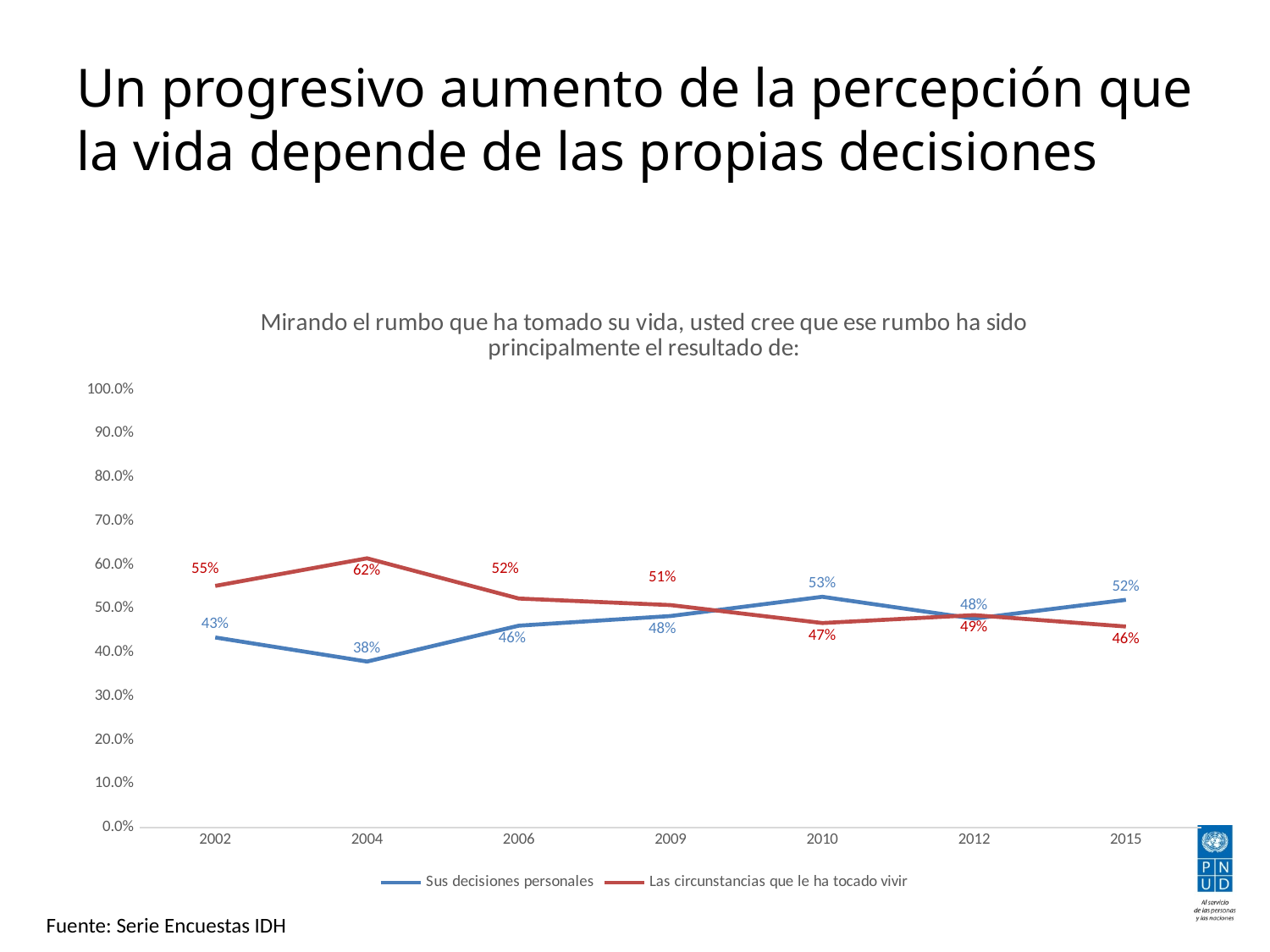
What is the value for 'Sus decisiones personales' in 2004? 38% What kind of chart is shown on the slide? Line chart In which year does 'Sus decisiones personales' have its lowest value? 2004 Does the 'Las circunstancias que le ha tocado vivir' series generally rise or fall from 2004 to 2015? Fall What is the difference between the two series in 2004? 24 percentage points What is the value for 'Las circunstancias que le ha tocado vivir' in 2004? 62% In 2010, which series has the larger value, 'Sus decisiones personales' or 'Las circunstancias que le ha tocado vivir'? Sus decisiones personales Which colour is used for the 'Sus decisiones personales' series? Blue How many series does the legend list? 2 In which year does 'Las circunstancias que le ha tocado vivir' reach its highest value? 2004 What is the value for 'Sus decisiones personales' in 2015? 52% How many years are plotted along the x axis? 7